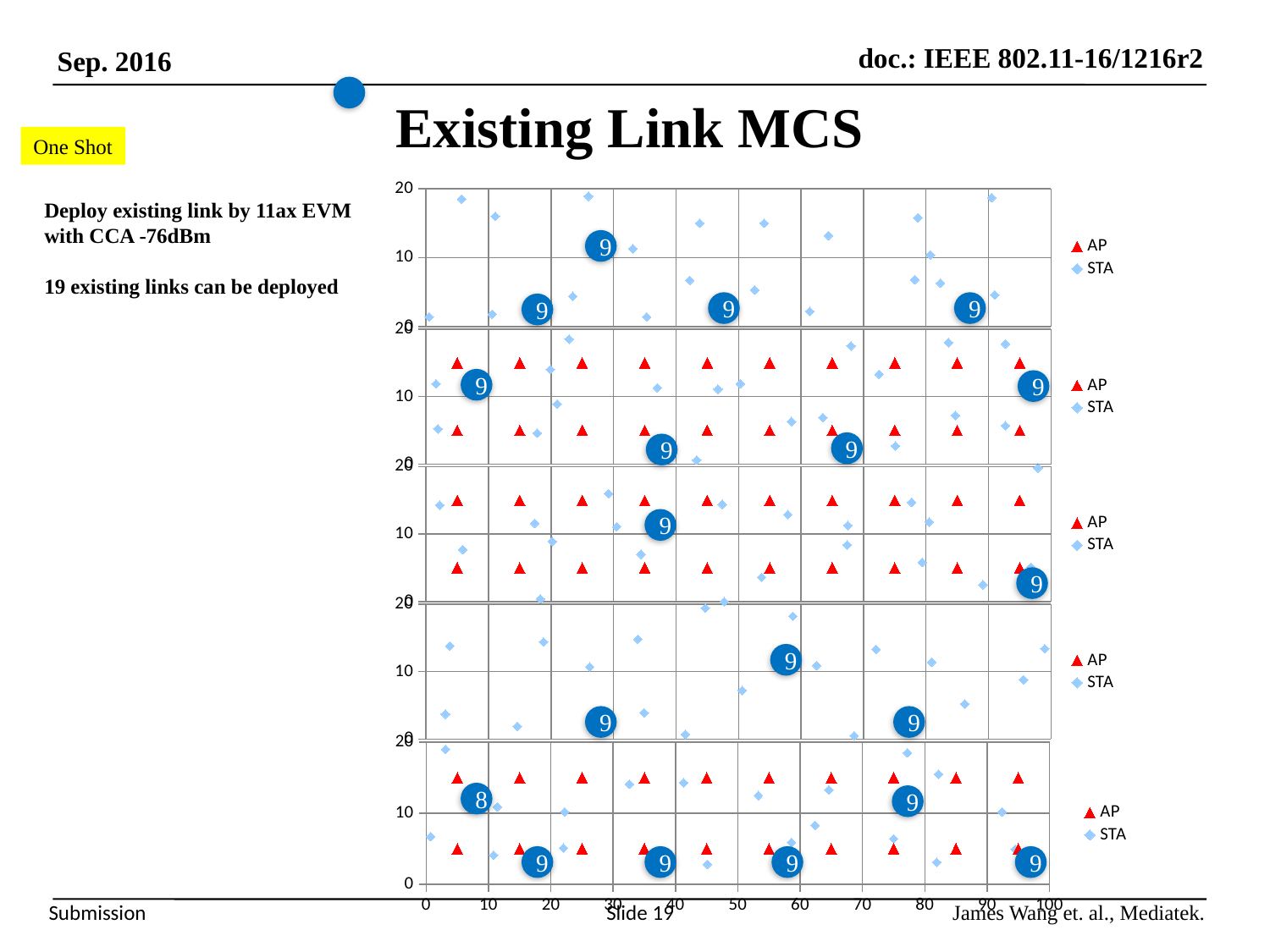
How many of the numbered circles on the slide show the value 8? 1 What is the largest tick value shown on the x axis of the bottom chart? 100 How many numbered blue circles appear in the bottom chart? 6 How many numbered blue circles appear across all the charts on the slide? 19 How many series does the legend of the top chart list? 2 What is the highest value shown on the y axis of the bottom chart? 20 What are the two legend entries shown next to the top chart? AP and STA Which series is drawn with red triangles in the charts? AP In the bottom chart, what number is shown in the circle that does not read 9? 8 What kind of chart is used in the panels on this slide? scatter chart